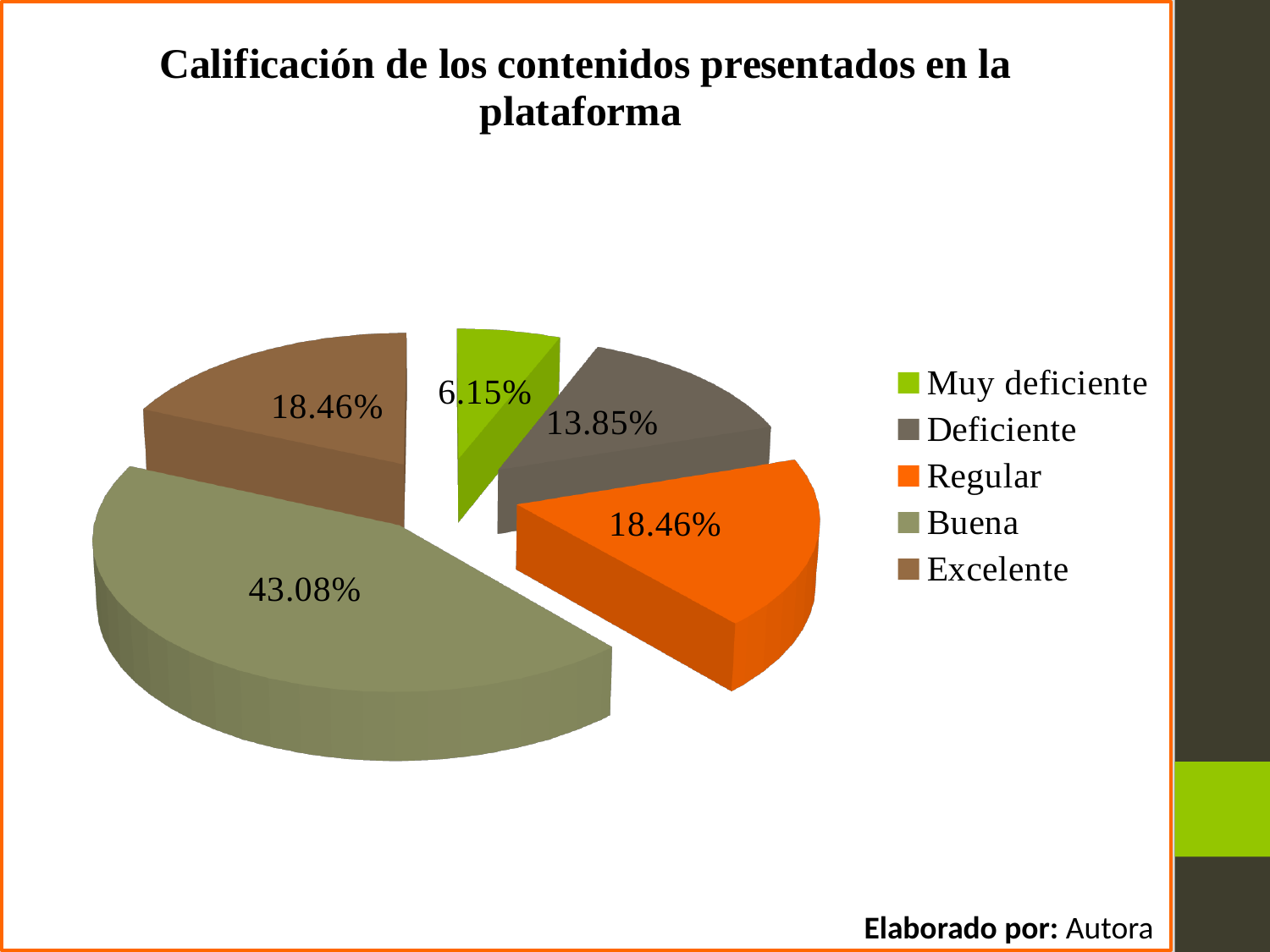
How many categories does the legend list? 5 What is the value for Deficiente? 13.85% Which category has the largest share of the pie? Buena Which is larger, the value for Deficiente or the value for Muy deficiente? Deficiente What is the value for Buena? 43.08% What kind of chart is shown on the slide? Pie chart What is the value for Excelente? 18.46% What is the value for Muy deficiente? 6.15% Which category has the smallest share of the pie? Muy deficiente What is the title of the chart? Calificación de los contenidos presentados en la plataforma What is the value for Regular? 18.46% What is the difference between the values for Buena and Deficiente? 29.23%